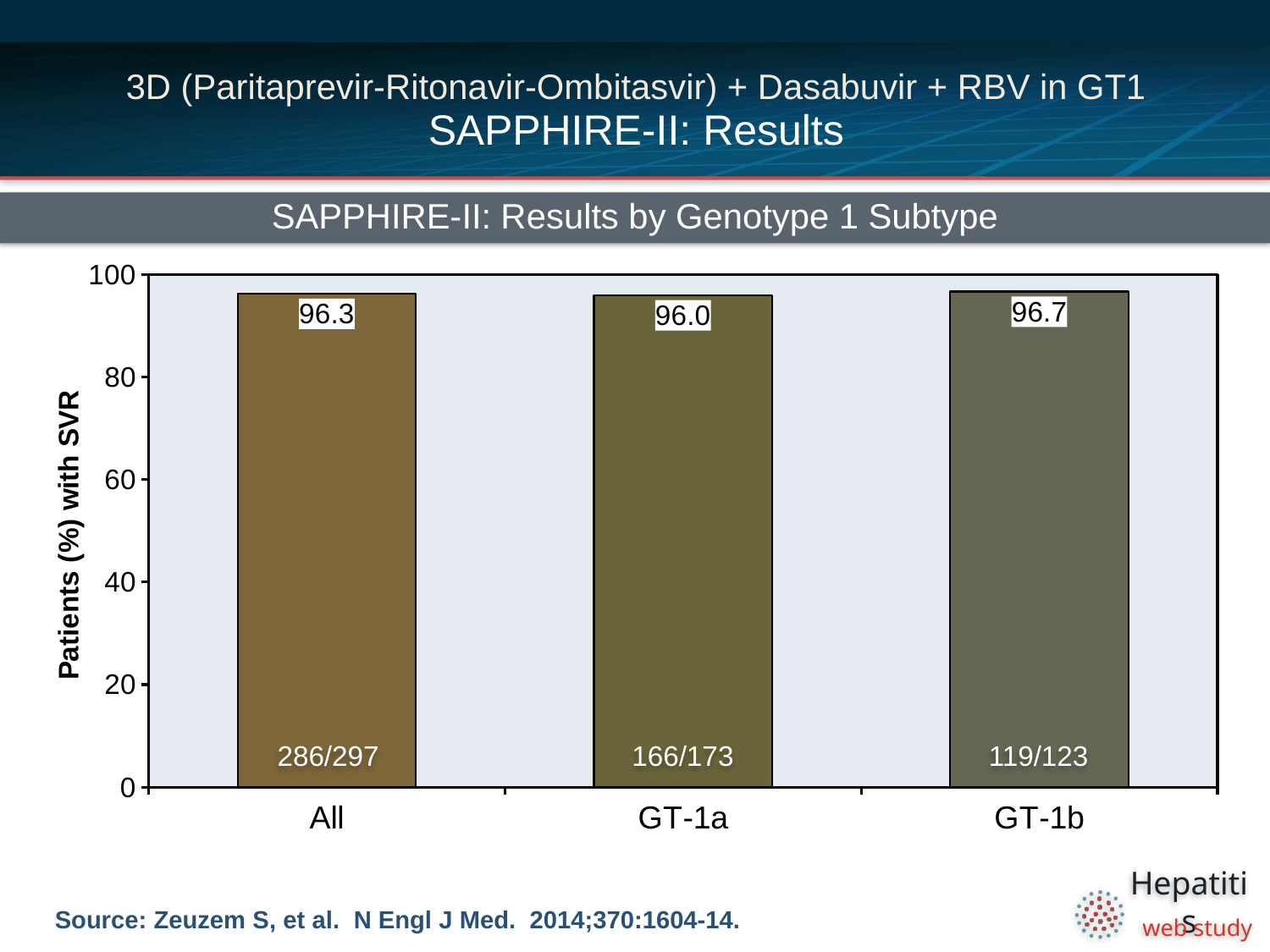
What is the label of the y axis? Patients (%) with SVR Is the SVR rate for GT-1b greater or less than 80? greater How many groups are shown on the x axis of the chart? 3 How many patients achieved SVR out of the total in the GT-1a group, as printed on the bar? 166/173 What fraction is printed on the All bar? 286/297 What is the SVR rate shown for the All group? 96.3 Which genotype subtype group has the highest SVR rate according to the data labels? GT-1b What is the SVR rate shown for the GT-1a group? 96.0 What type of chart is shown on the slide? bar chart What is the SVR rate shown for the GT-1b group? 96.7 What is the difference in SVR rate between GT-1b and GT-1a? 0.7 Which group has the lowest SVR rate according to the data labels? GT-1a